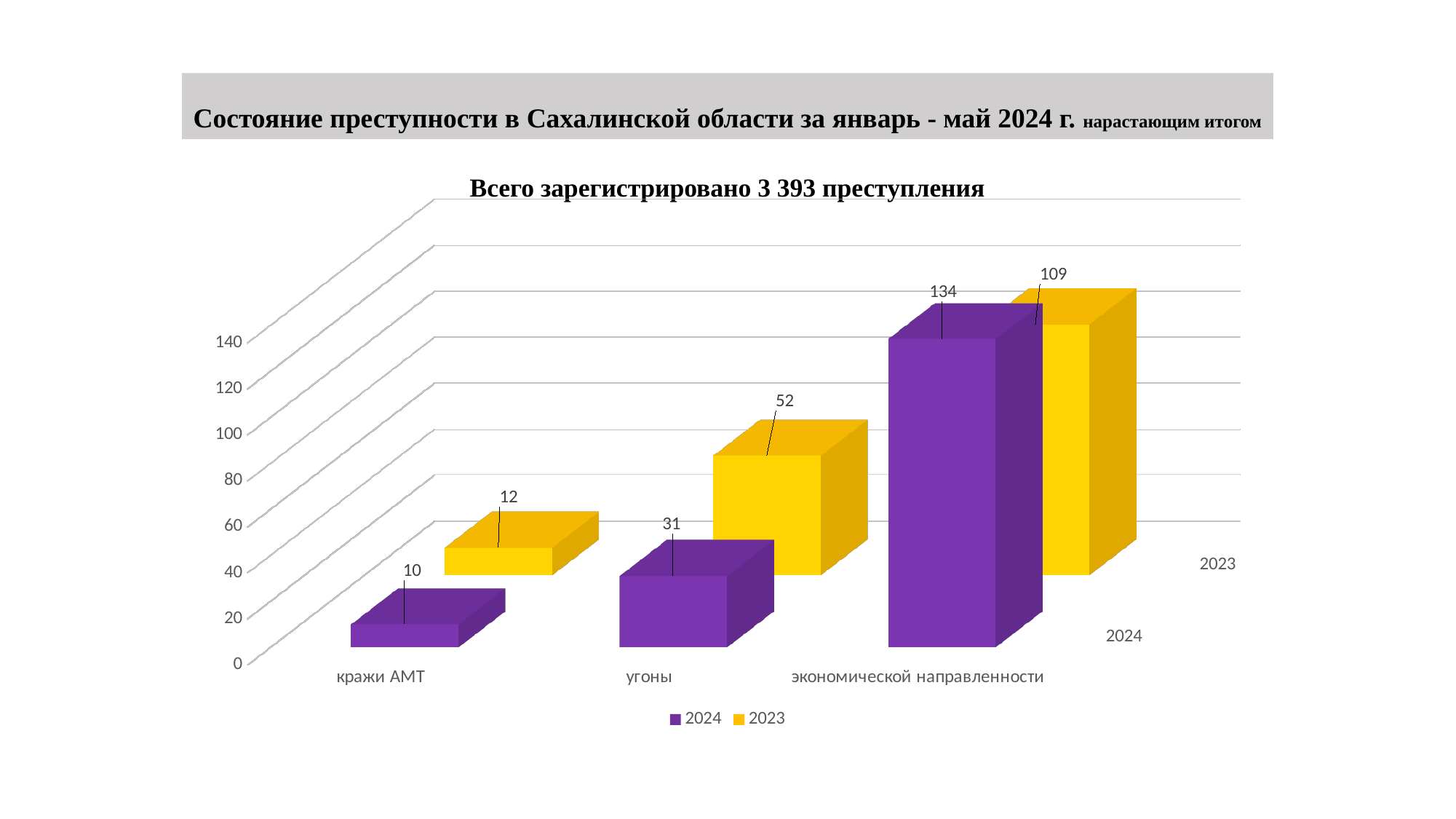
What is the value for экономической направленности in the 2023 series? 109 What is the value for кражи АМТ in the 2024 series? 10 How many series does the legend list? 2 Which category has the lowest value in the 2023 series? кражи АМТ Which category has the highest value in the 2024 series? экономической направленности What kind of chart is shown on the slide? bar chart What is the value for экономической направленности in the 2024 series? 134 What is the title of the chart? Всего зарегистрировано 3 393 преступления What is the difference between the 2024 and 2023 values for экономической направленности? 25 What is the value for угоны in the 2023 series? 52 Which is larger for угоны: the 2024 value or the 2023 value? 2023 How many categories are shown on the x axis? 3